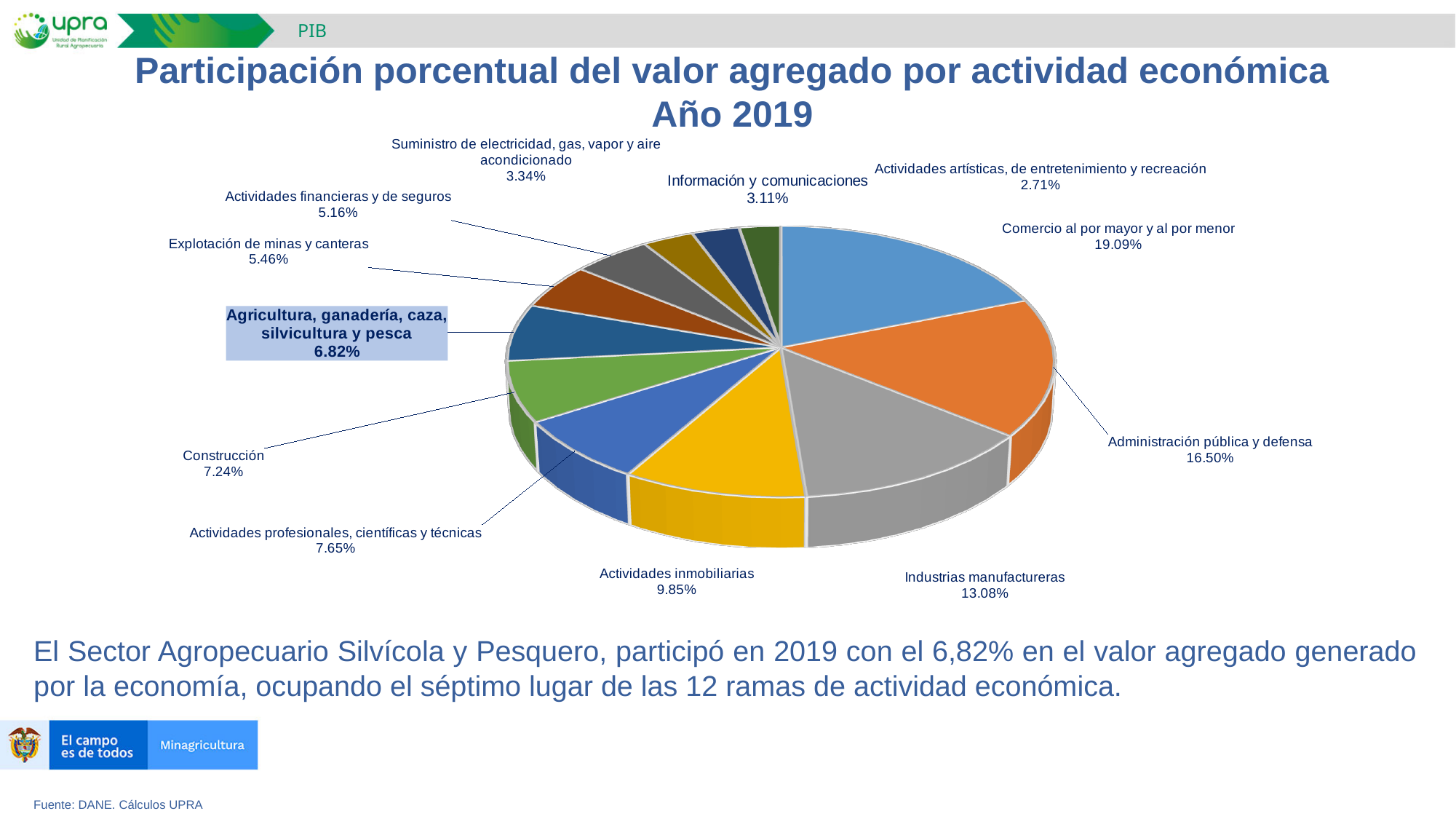
How many activities (slices) are shown in the pie chart? 12 What is the share for Industrias manufactureras? 13.08% Which activity has the largest share of the pie? Comercio al por mayor y al por menor What is the share for Agricultura, ganadería, caza, silvicultura y pesca? 6.82% What is the difference between the shares of Comercio al por mayor y al por menor and Administración pública y defensa? 2.59% What year does the chart title refer to? 2019 Which activity has the smallest share of the pie? Actividades artísticas, de entretenimiento y recreación Which has a larger share, Construcción or Actividades profesionales, científicas y técnicas? Actividades profesionales, científicas y técnicas What kind of chart is shown on the slide? Pie chart What is the share for Actividades inmobiliarias? 9.85% What is the share for Comercio al por mayor y al por menor? 19.09% What is the share for Actividades artísticas, de entretenimiento y recreación? 2.71%